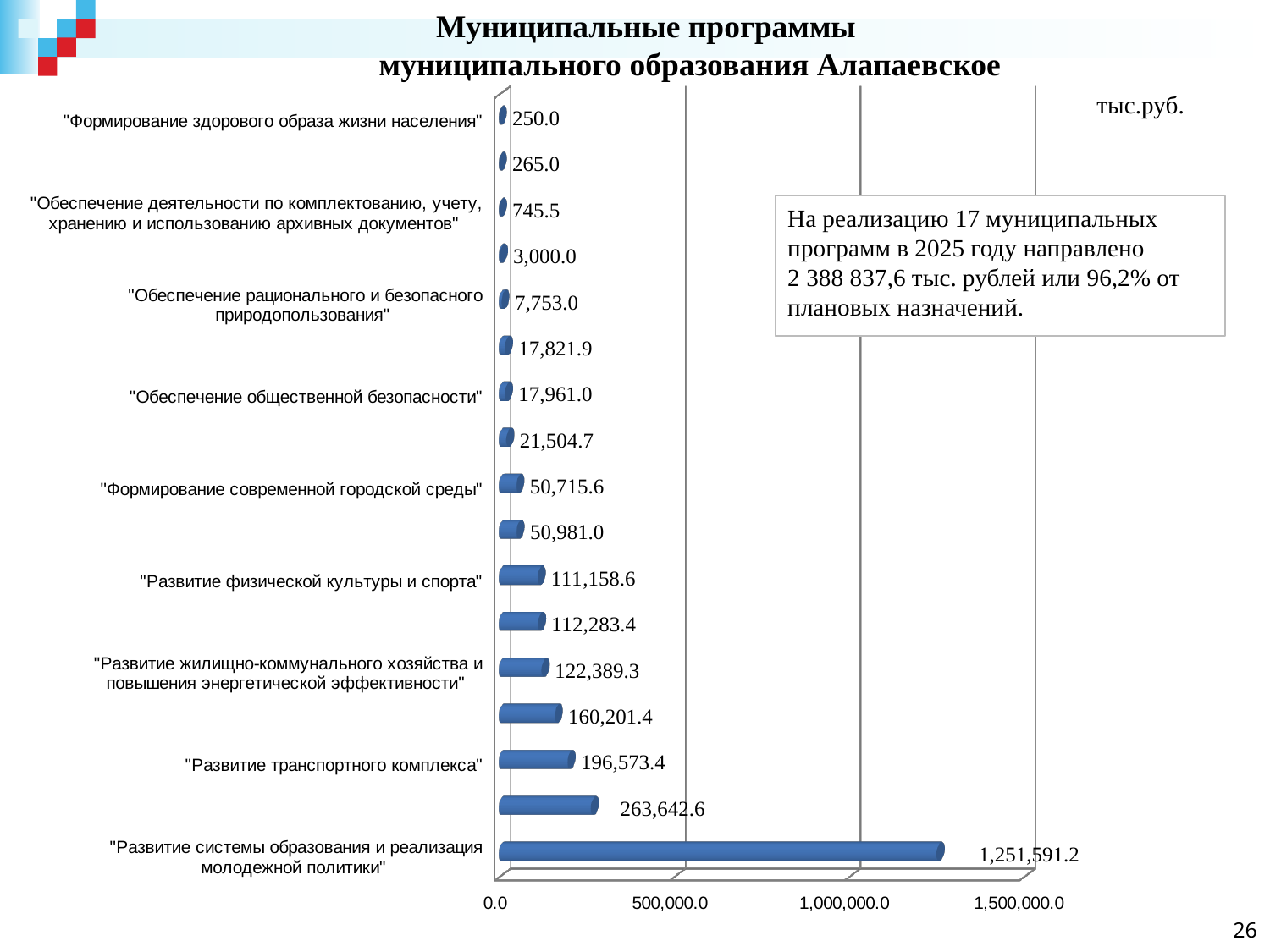
What is the value for "Формирование современной городской среды"? 50,715.6 How many bars are plotted in the chart? 17 What is the value for "Развитие системы образования и реализация молодежной политики"? 1,251,591.2 What is the value for "Обеспечение общественной безопасности"? 17,961.0 What kind of chart is shown on the slide? bar chart Is the value for "Развитие системы образования и реализация молодежной политики" greater or less than 1,000,000.0? greater Which is larger: the value for "Развитие физической культуры и спорта" or for "Формирование современной городской среды"? "Развитие физической культуры и спорта" Which program has the lowest value? "Формирование здорового образа жизни населения" What unit of measurement is indicated for the chart values? тыс.руб. What is the difference between the values for "Развитие транспортного комплекса" and "Развитие жилищно-коммунального хозяйства и повышения энергетической эффективности"? 74,184.1 Which program has the highest value? "Развитие системы образования и реализация молодежной политики" What is the value for "Развитие транспортного комплекса"? 196,573.4